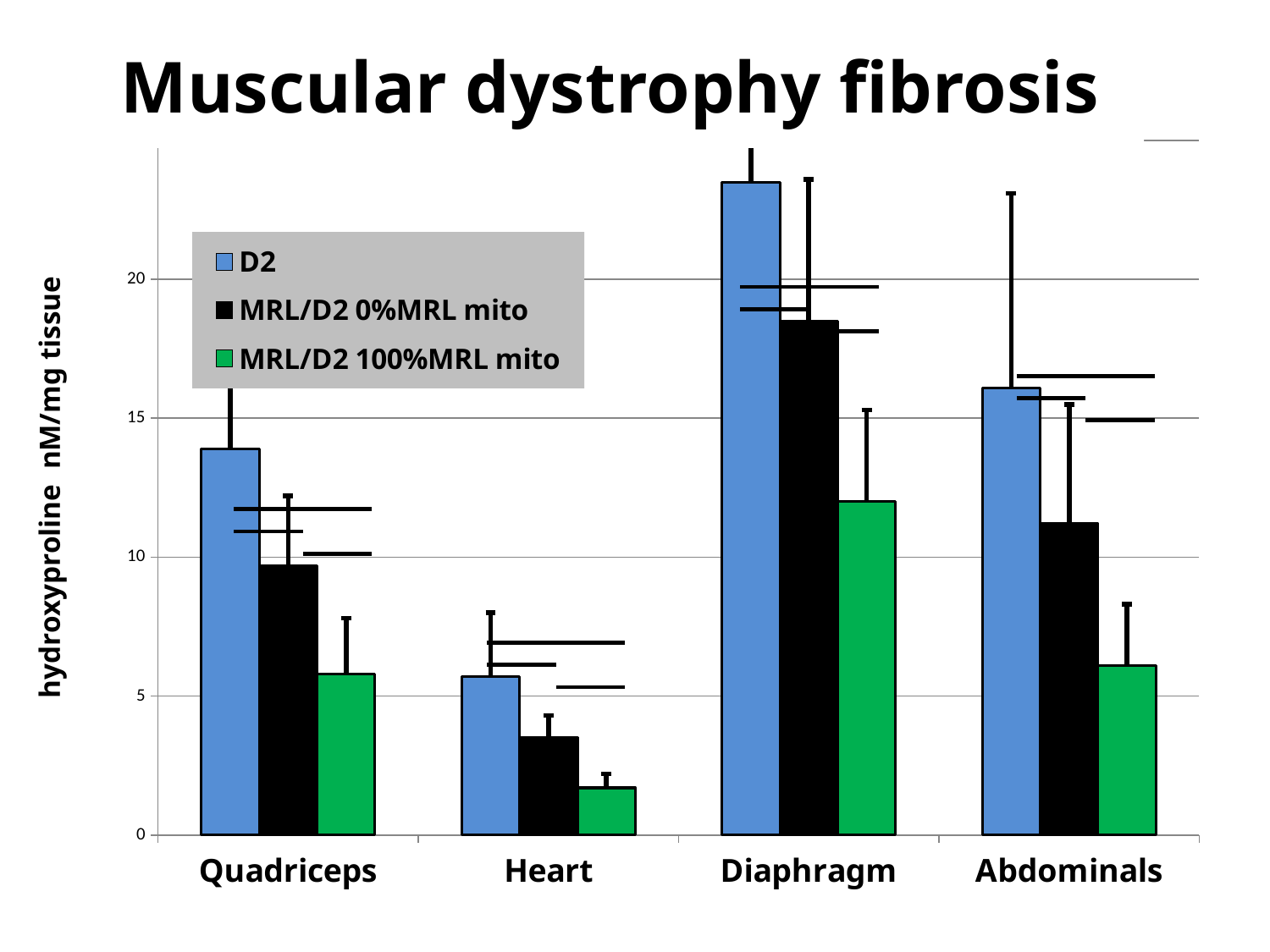
What is the label on the y axis? hydroxyproline nM/mg tissue Is the D2 value for Diaphragm greater or less than 20? greater How many series does the legend list? 3 Is the D2 value for Quadriceps greater or less than 10? greater What kind of chart is shown on the slide? bar chart Is the MRL/D2 100%MRL mito value for Heart greater or less than 5? less Which muscle has the highest D2 value? Diaphragm Which is larger, the MRL/D2 0%MRL mito value for Heart or the MRL/D2 100%MRL mito value for Quadriceps? MRL/D2 100%MRL mito value for Quadriceps Which muscle has the lowest MRL/D2 100%MRL mito value? Heart How many muscle categories are shown on the x axis? 4 Which is larger, the D2 value for Quadriceps or the D2 value for Abdominals? Abdominals